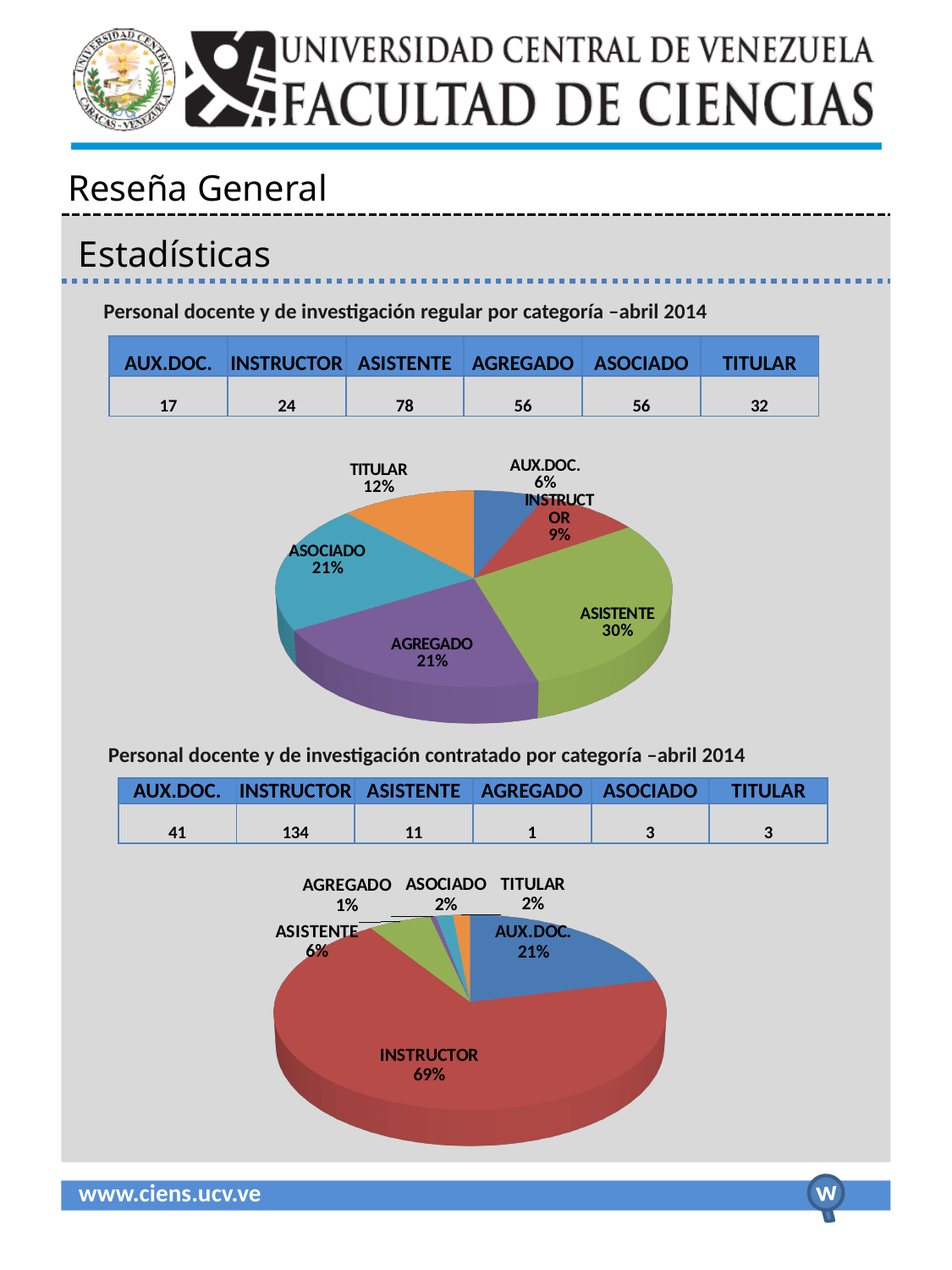
In the bottom pie chart (contracted staff by category), which category has the smallest slice? AGREGADO In the bottom pie chart (contracted staff by category), what share does AUX.DOC. have? 21% In the bottom pie chart (contracted staff by category), what share does INSTRUCTOR have? 69% In the top pie chart (regular staff by category), which category has the largest slice? ASISTENTE In the top pie chart (regular staff by category), what share does ASISTENTE have? 30% In the top pie chart (regular staff by category), what is the difference in percentage points between ASISTENTE and INSTRUCTOR? 21 In the top pie chart (regular staff by category), how many categories are shown? 6 What is the title of the top chart on the slide? Personal docente y de investigación regular por categoría –abril 2014 In the bottom pie chart (contracted staff by category), which is larger, ASISTENTE or TITULAR? ASISTENTE What type of chart is used for the contracted staff by category data at the bottom of the slide? Pie chart In the top pie chart (regular staff by category), which category has the smallest slice? AUX.DOC.